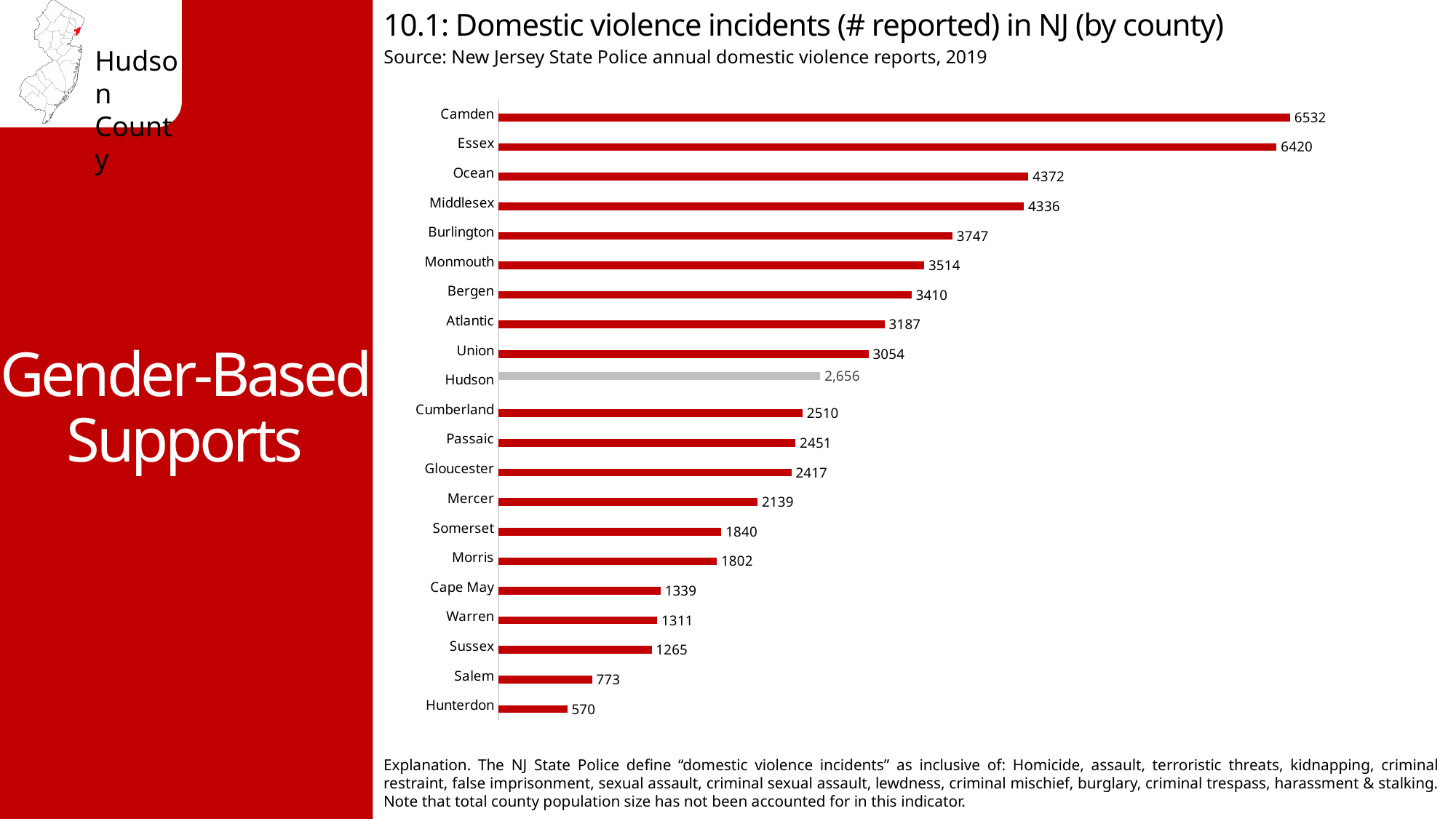
Which county has the lowest number of reported domestic violence incidents? Hunterdon How many counties are shown in the chart? 21 Which county has more reported incidents, Bergen or Atlantic? Bergen Which county has more reported incidents, Salem or Sussex? Sussex What is the number of reported domestic violence incidents for Camden? 6532 Which county has the highest number of reported domestic violence incidents? Camden What is the difference between the number of incidents in Camden and Essex? 112 What kind of chart is used to show domestic violence incidents by county? Bar chart Which county's bar is shown in grey rather than red? Hudson What is the number of reported domestic violence incidents for Hunterdon? 570 What is the number of reported domestic violence incidents for Hudson County? 2,656 What is the difference between the number of incidents in Ocean and Middlesex? 36